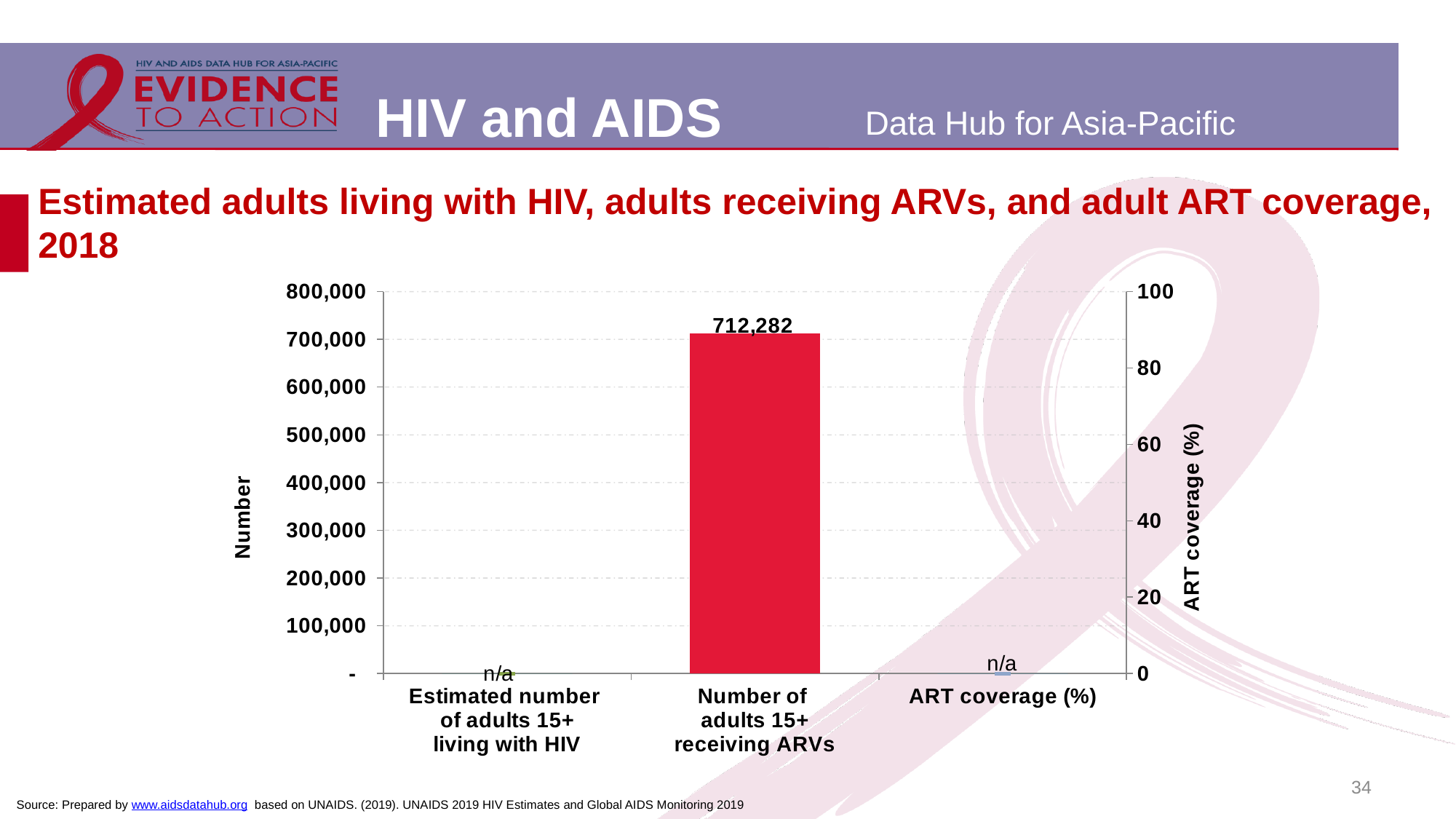
What is the title of the left vertical axis? Number What is the title of the right vertical axis? ART coverage (%) What kind of chart is shown on the slide? Bar chart What is the maximum value shown on the left vertical axis? 800,000 Which category has the highest plotted value? Number of adults 15+ receiving ARVs Is the value for Number of adults 15+ receiving ARVs greater or less than 800,000? less What value is shown for Estimated number of adults 15+ living with HIV? n/a How many categories are labelled n/a? 2 What is the value for Number of adults 15+ receiving ARVs? 712,282 Is the value for Number of adults 15+ receiving ARVs greater or less than 700,000? greater How many categories are shown on the x axis? 3 What value is shown for ART coverage (%)? n/a